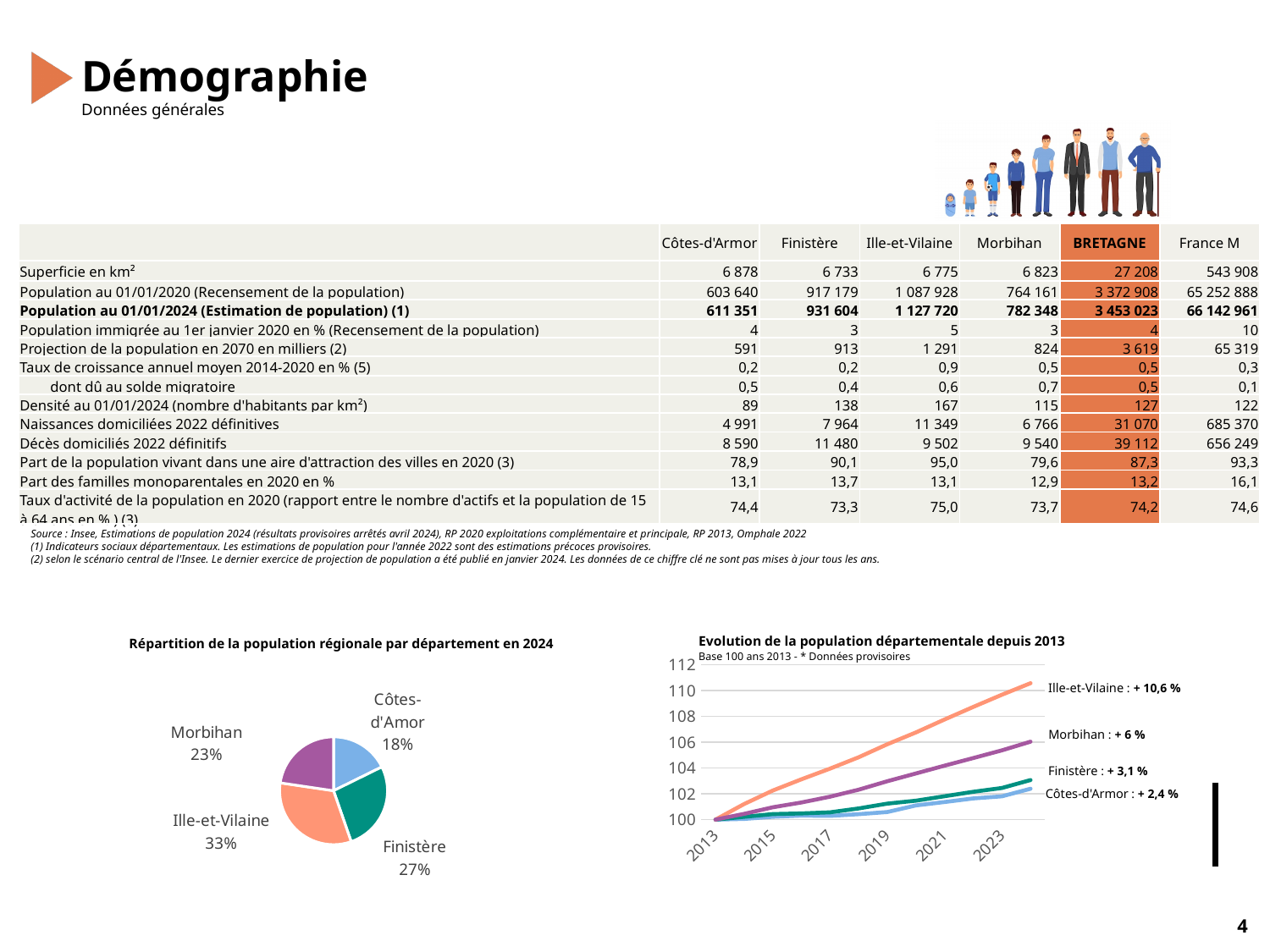
In the chart 'Evolution de la population départementale depuis 2013', is the value for Côtes-d'Armor in 2023 greater or less than 104? less In the pie chart 'Répartition de la population régionale par département en 2024', what is the difference in percentage points between Finistère and Côtes-d'Armor? 9 percentage points In the chart 'Evolution de la population départementale depuis 2013', what growth is indicated for Morbihan? + 6 % In the chart 'Evolution de la population départementale depuis 2013', which department shows the highest growth since 2013? Ille-et-Vilaine How many departments (lines) are plotted in the chart 'Evolution de la population départementale depuis 2013'? 4 In the pie chart 'Répartition de la population régionale par département en 2024', what share does Ille-et-Vilaine have? 33% What kind of chart is 'Evolution de la population départementale depuis 2013'? Line chart In the pie chart 'Répartition de la population régionale par département en 2024', which department has the largest share? Ille-et-Vilaine What kind of chart is 'Répartition de la population régionale par département en 2024'? Pie chart In the chart 'Evolution de la population départementale depuis 2013', do the lines rise or fall from 2013 to 2023? Rise How many slices does the pie chart 'Répartition de la population régionale par département en 2024' have? 4 In the pie chart 'Répartition de la population régionale par département en 2024', which department has the smallest share? Côtes-d'Armor